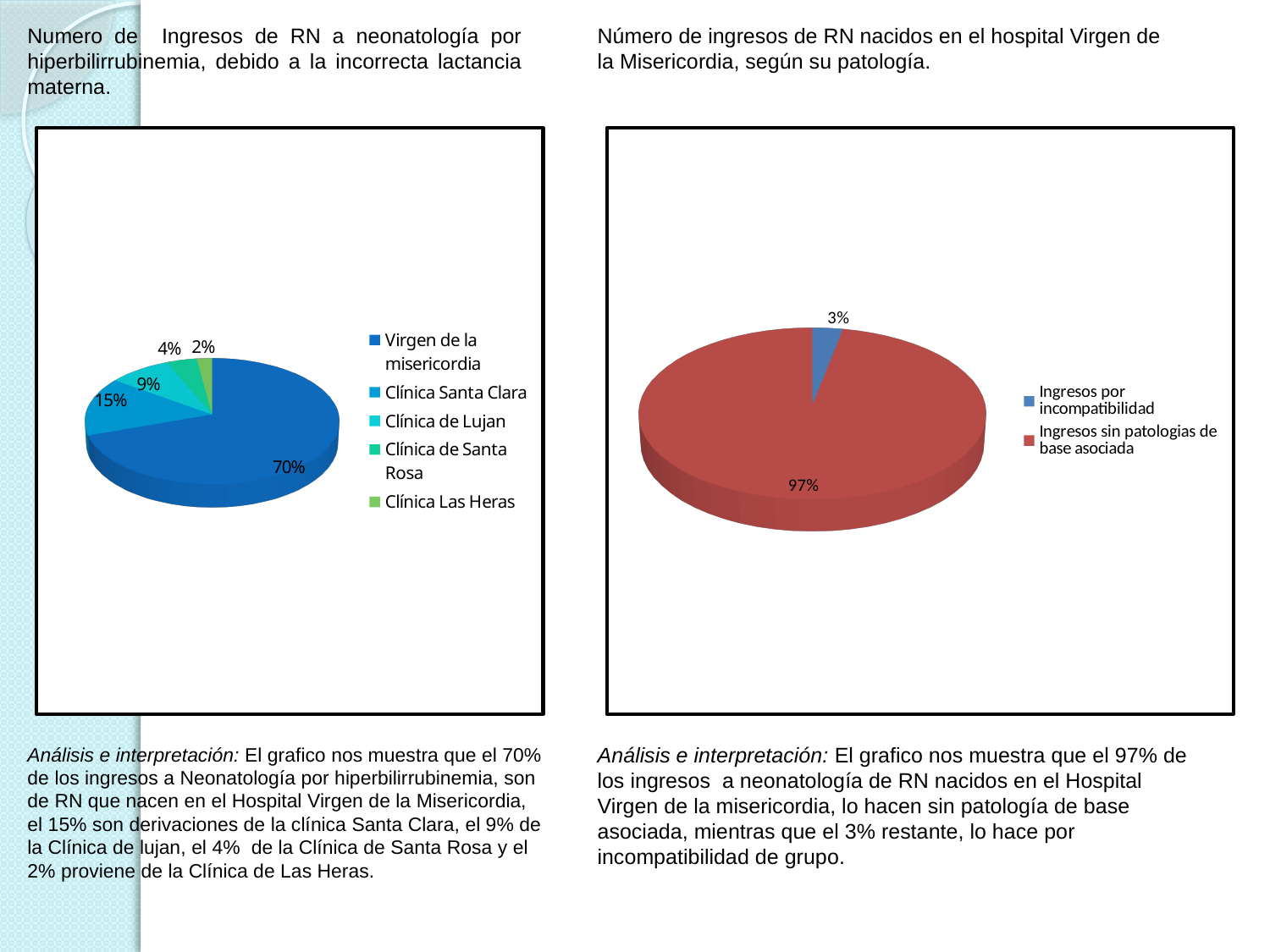
In the right pie chart, what share of admissions is 'Ingresos por incompatibilidad'? 3% In the left pie chart, what is the difference in percentage points between Clínica Santa Clara and Clínica de Santa Rosa? 11 In the left pie chart, what share of admissions comes from Clínica de Lujan? 9% What kind of chart is shown on the right side of the slide? Pie chart In the left pie chart, which category has the largest slice? Virgen de la misericordia In the right pie chart, what share of admissions is 'Ingresos sin patologias de base asociada'? 97% In the left pie chart, which category has the smallest slice? Clínica Las Heras In the left pie chart, how many categories does the legend list? 5 In the right pie chart, which is larger: 'Ingresos por incompatibilidad' or 'Ingresos sin patologias de base asociada'? Ingresos sin patologias de base asociada